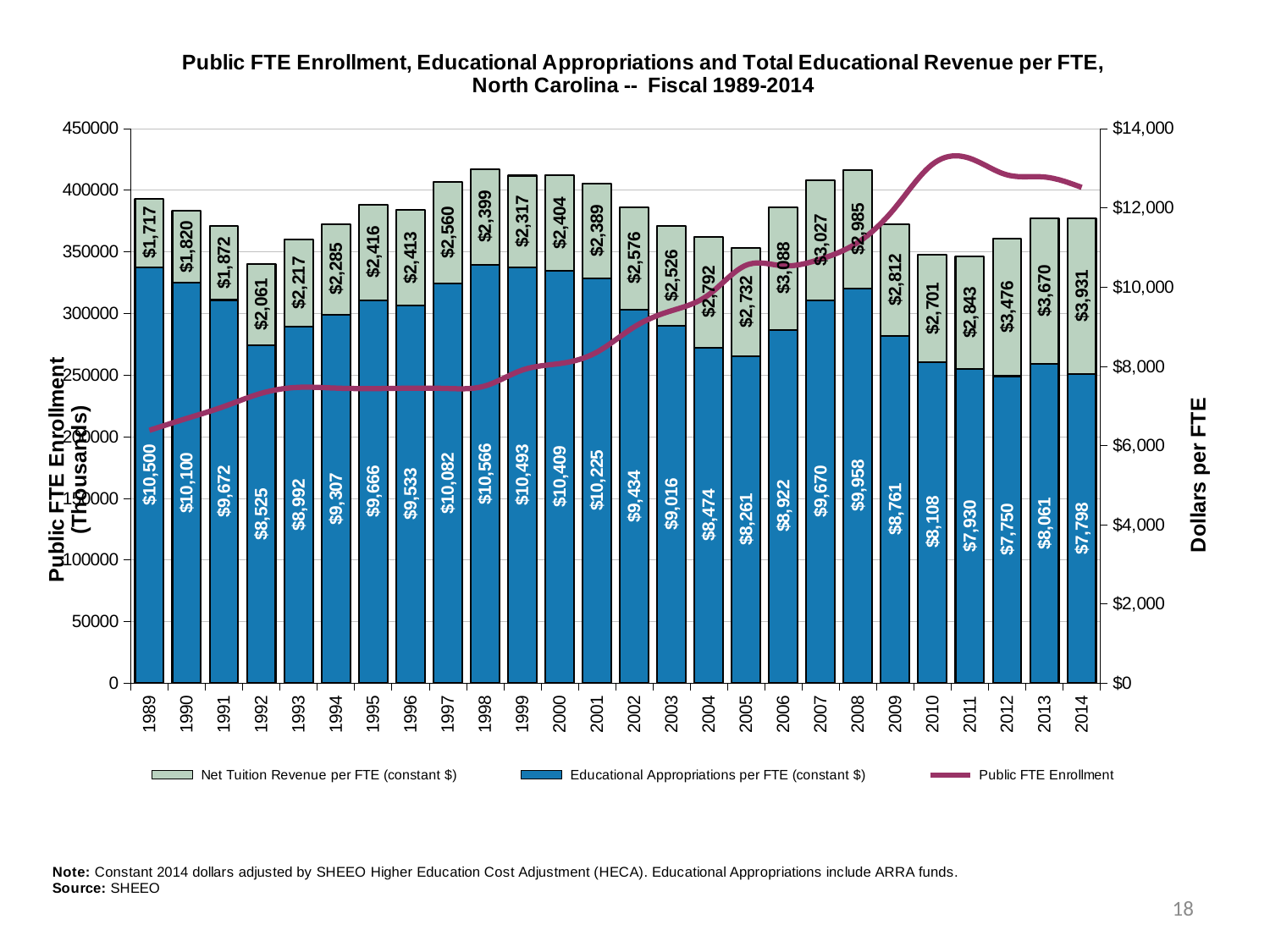
What is the Educational Appropriations per FTE value for 1998? $10,566 What is the Educational Appropriations per FTE value for 2012? $7,750 Which year has the highest Educational Appropriations per FTE? 1998 How many series does the legend list? 3 Is the Public FTE Enrollment value for 1989 greater or less than 250000? less Which year has the lowest Net Tuition Revenue per FTE? 1989 What is the total of the stacked bar (appropriations plus net tuition) for 2014? $11,729 Which is larger, Educational Appropriations per FTE in 1989 or in 2014? 1989 What is the difference between Net Tuition Revenue per FTE in 2014 and in 1989? $2,214 How many fiscal years are shown on the x axis? 26 Does the Public FTE Enrollment line generally rise or fall from 1989 to 2014? rise What is the Net Tuition Revenue per FTE value for 2014? $3,931